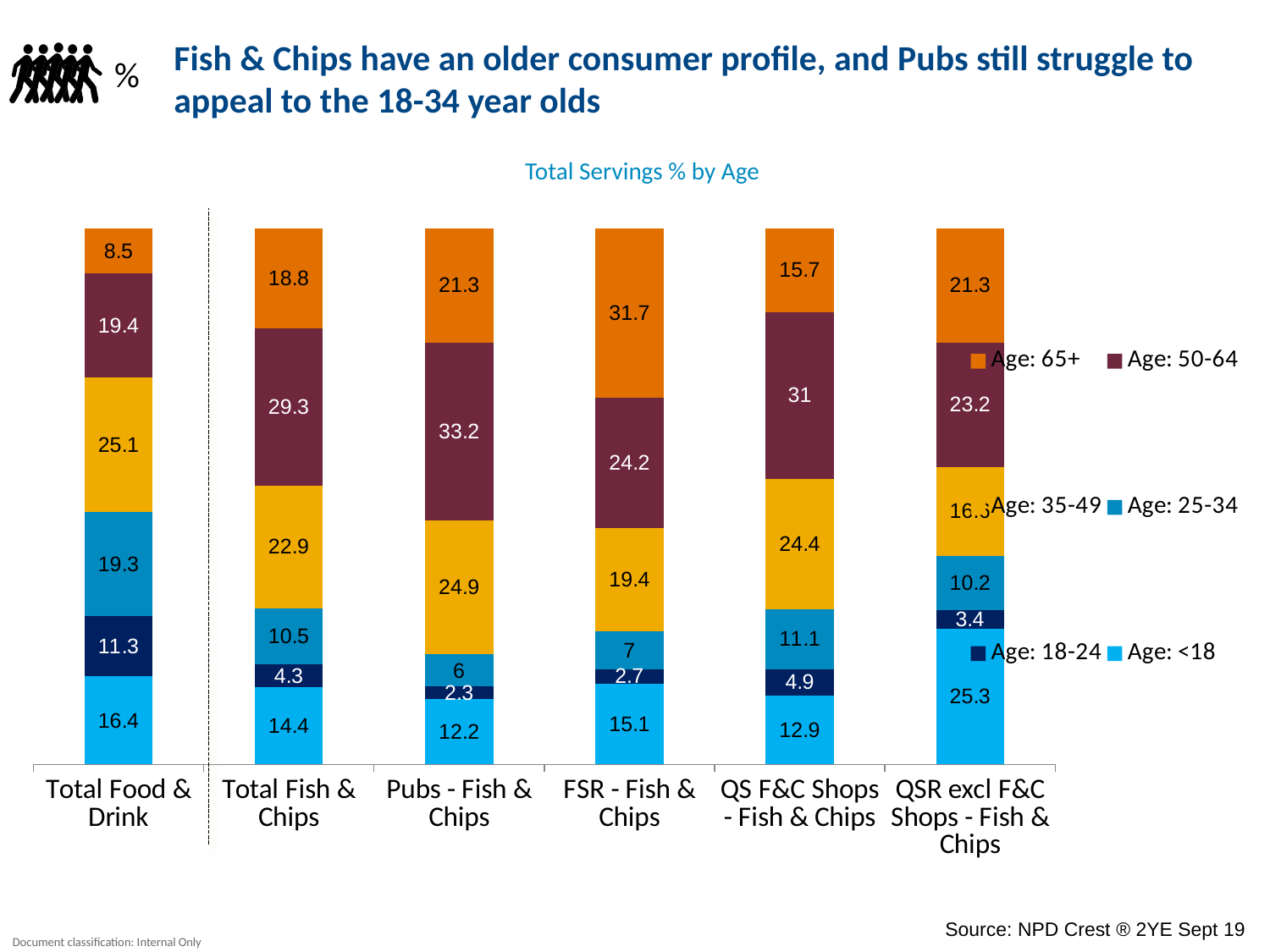
Which has the larger Age: 25-34 value, Total Food & Drink or QS F&C Shops - Fish & Chips? Total Food & Drink What kind of chart is shown on the slide? Stacked bar chart Which category has the highest value for Age: 65+? FSR - Fish & Chips What is the title of the chart? Total Servings % by Age What is the value for Age: <18 in the QSR excl F&C Shops - Fish & Chips bar? 25.3 What is the difference between the Age: 50-64 value for Pubs - Fish & Chips and for Total Food & Drink? 13.8 What is the value for Age: 65+ in the FSR - Fish & Chips bar? 31.7 Which category has the lowest value for Age: 18-24? Pubs - Fish & Chips How many categories are shown on the x axis? 6 What is the value for Age: 50-64 in the Pubs - Fish & Chips bar? 33.2 How many series does the legend list? 6 What is the value for Age: 18-24 in the Total Fish & Chips bar? 4.3